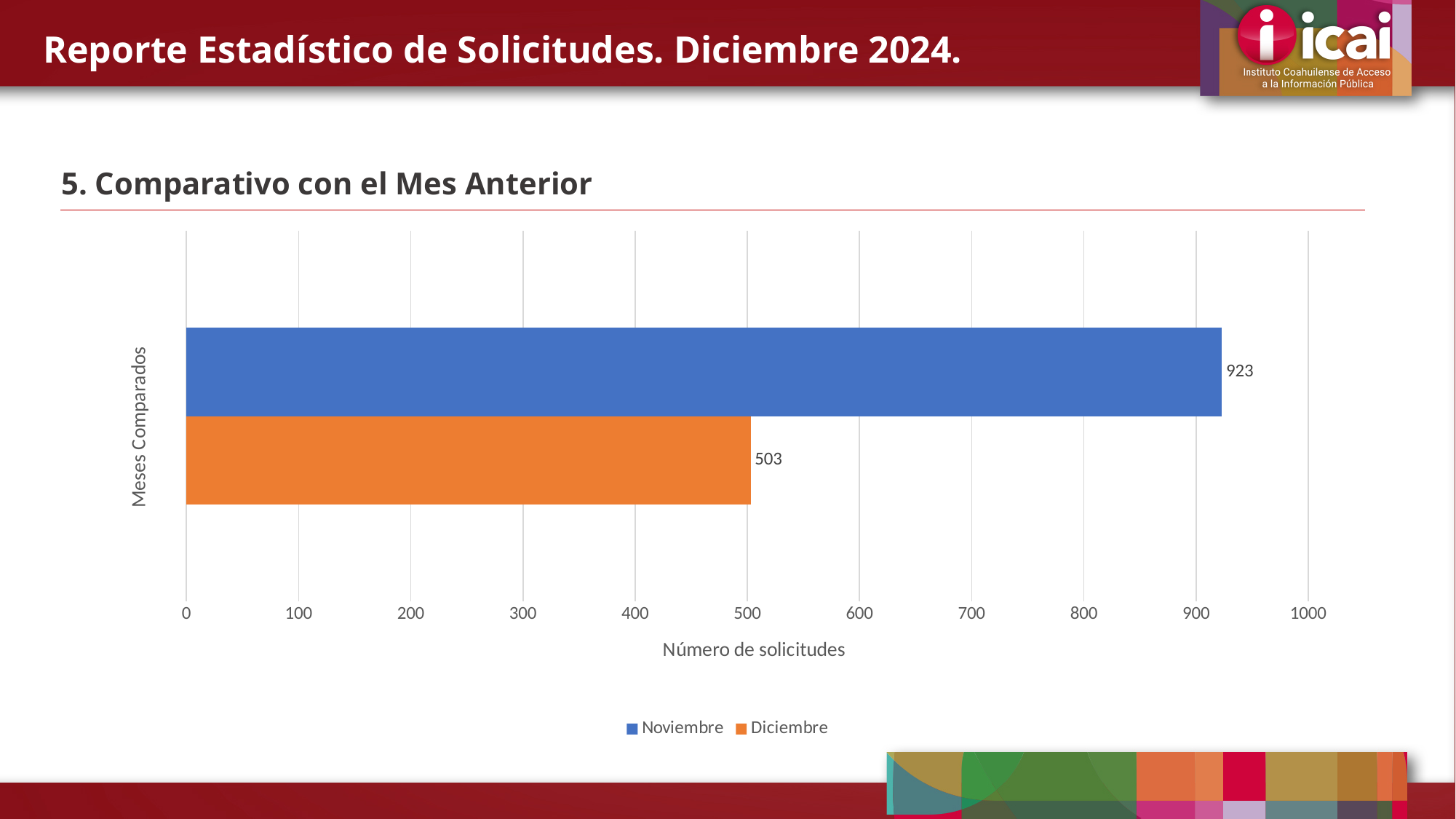
What is the value for Diciembre? 503 Which series has the higher value, Noviembre or Diciembre? Noviembre What is the value for Noviembre? 923 Is the value for Noviembre greater or less than 900? greater What is the difference between the Noviembre and Diciembre values? 420 How many series does the legend list? 2 Is the value for Diciembre larger or smaller than the value for Noviembre? smaller Is the value for Diciembre greater or less than 600? less What colour is the bar for Diciembre? orange Which series has the lower value, Noviembre or Diciembre? Diciembre What is the label of the horizontal axis? Número de solicitudes What kind of chart is shown on the slide? bar chart